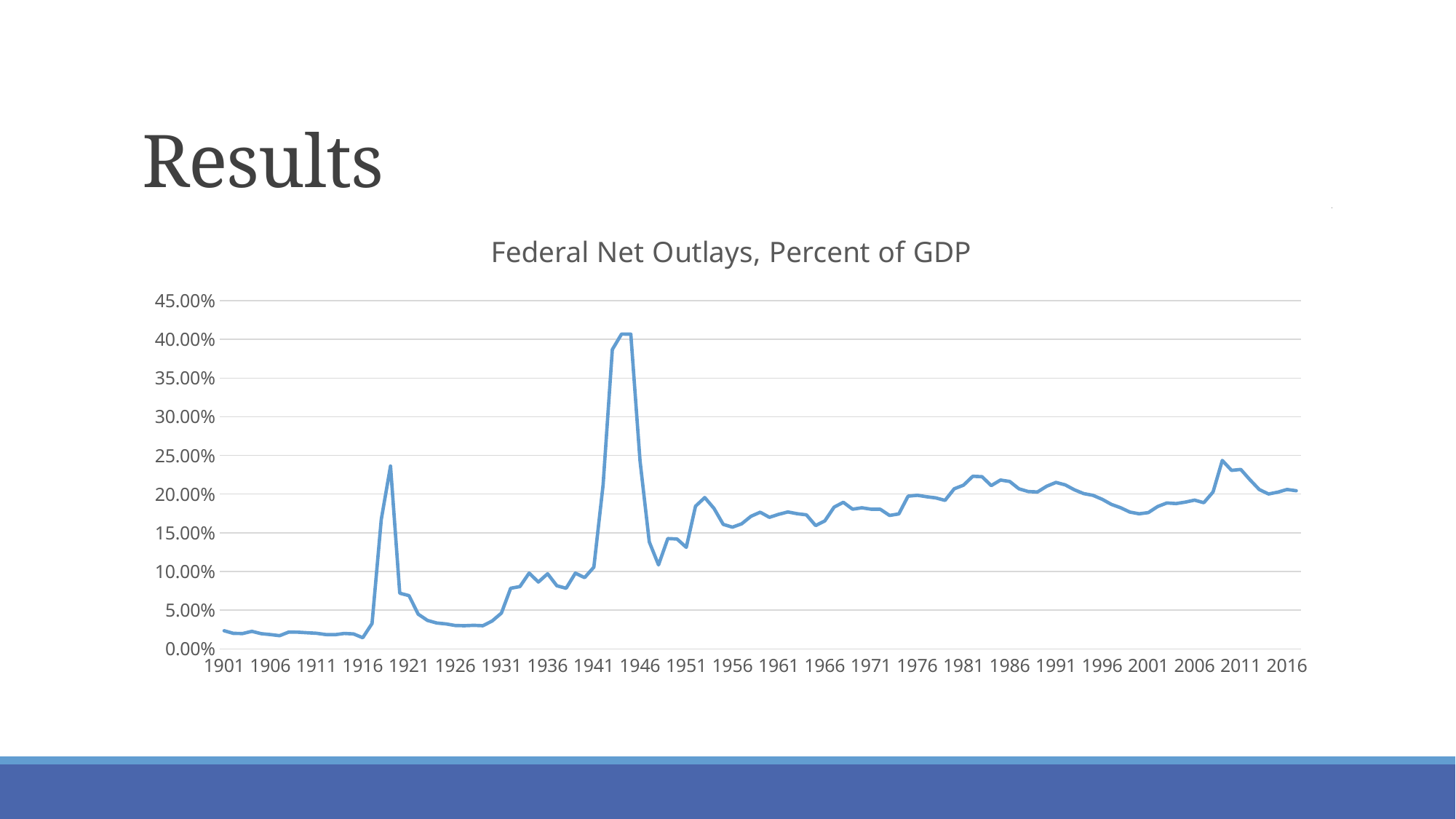
Does the line rise or fall between 2011 and 2016? fall Is the value for 1941 greater or less than 15.00%? less What type of chart is shown on the slide? line chart Is the value for 2011 greater or less than 20.00%? greater Which is larger, the value for 1901 or the value for 2016? 2016 Which is higher, the spike around 1919 or the spike around 1944? the spike around 1944 How many lines (data series) are plotted on the chart? 1 Is the value for 1901 greater or less than 5.00%? less What is the title of the chart? Federal Net Outlays, Percent of GDP How many year labels are shown on the x axis? 24